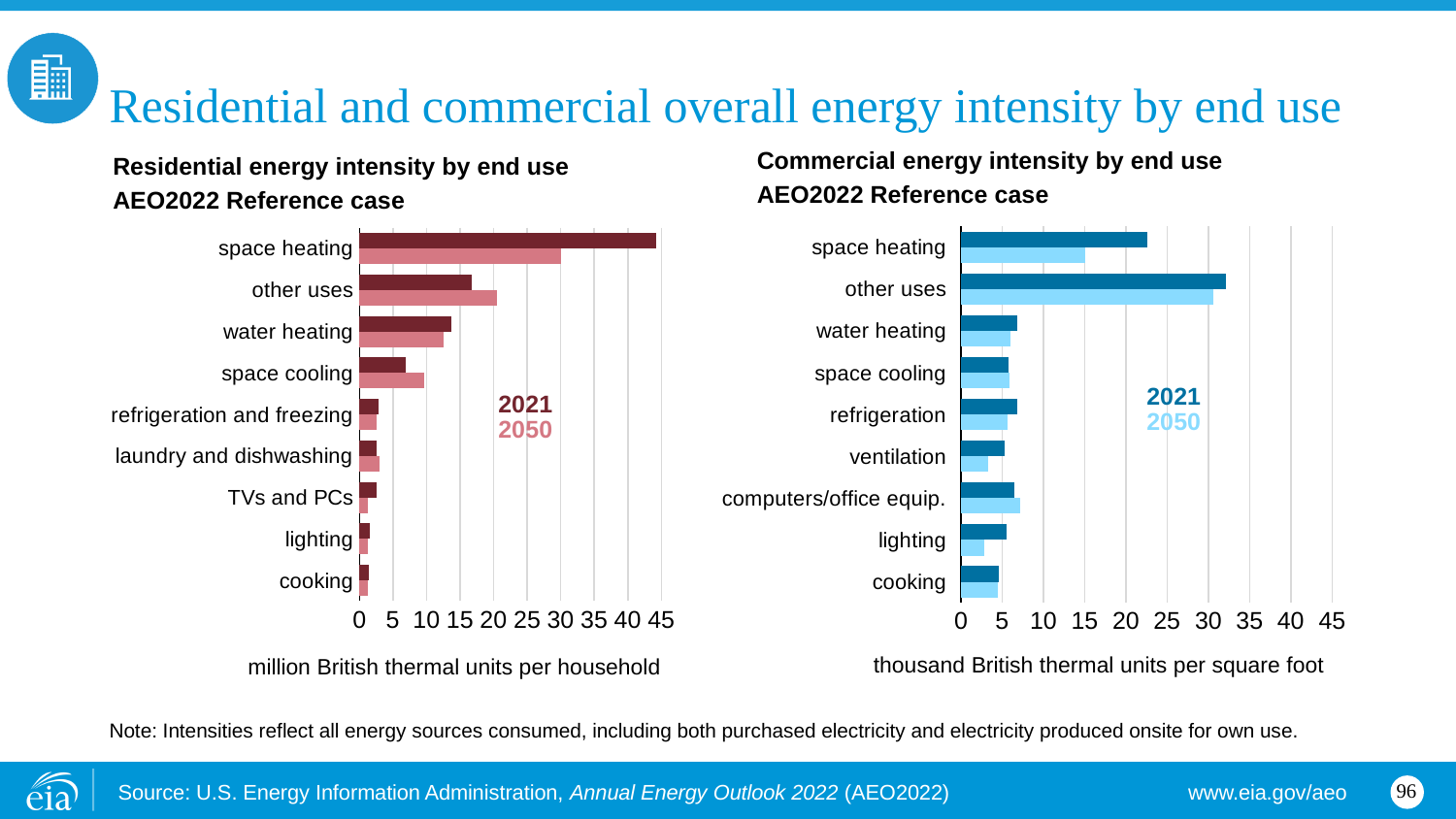
In the 'Commercial energy intensity by end use' chart, is the 2050 value for space heating greater or less than 20? less What kind of chart is the 'Residential energy intensity by end use' chart? bar chart In the 'Residential energy intensity by end use' chart, which end use has the highest 2021 value? space heating In the 'Residential energy intensity by end use' chart, is the 2021 value for space heating greater or less than 40? greater How many end-use categories are shown in the 'Residential energy intensity by end use' chart? 9 How many series does the legend list in the 'Commercial energy intensity by end use' chart? 2 In the 'Commercial energy intensity by end use' chart, which end use has the highest 2021 value? other uses What unit is shown on the x axis of the 'Commercial energy intensity by end use' chart? thousand British thermal units per square foot In the 'Residential energy intensity by end use' chart, which is larger for space heating: the 2021 value or the 2050 value? 2021 In the 'Commercial energy intensity by end use' chart, which is larger for lighting: the 2021 value or the 2050 value? 2021 In the 'Residential energy intensity by end use' chart, which is larger for other uses: the 2021 value or the 2050 value? 2050